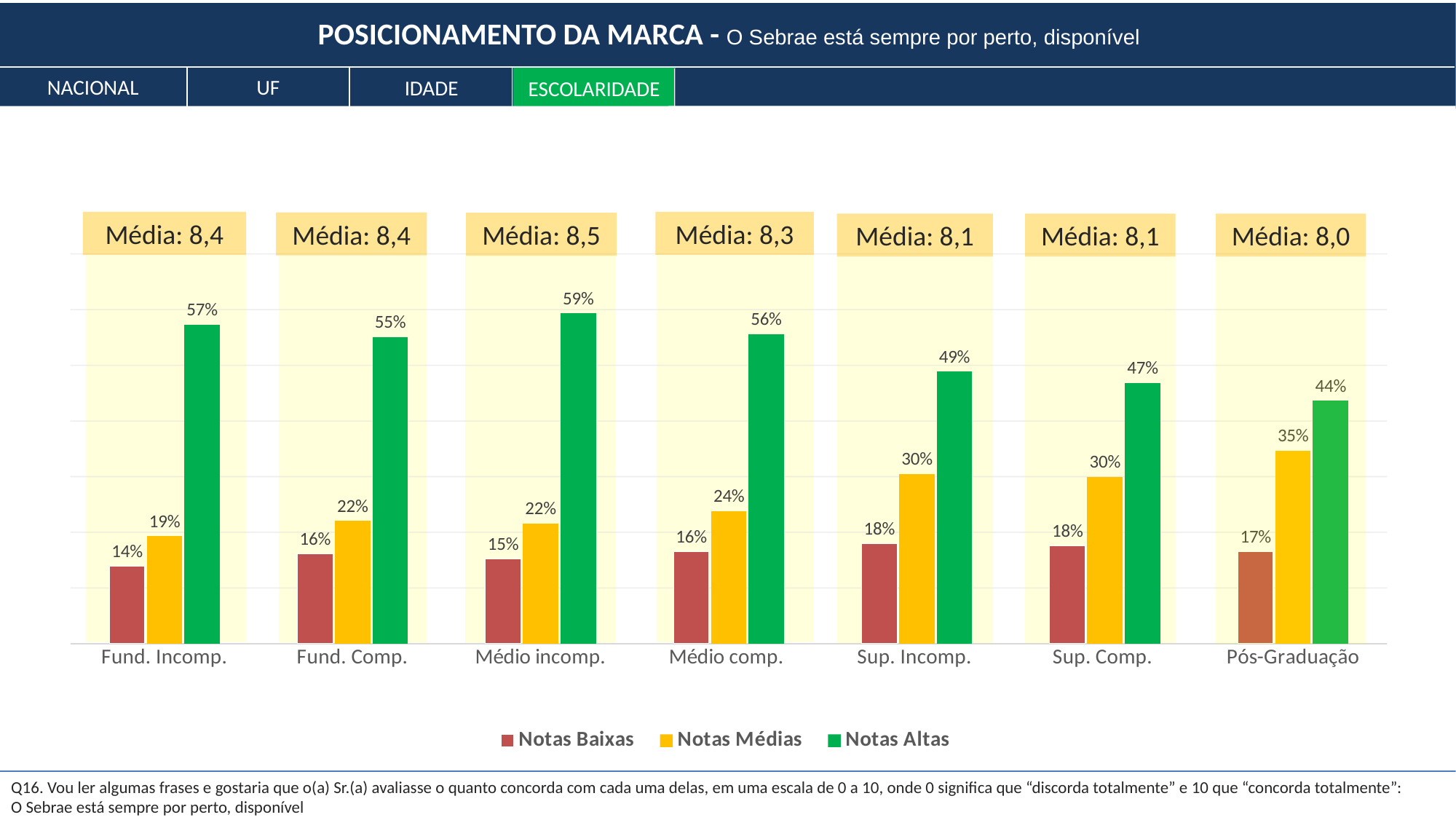
Which category has the lowest Notas Altas value? Pós-Graduação How many series does the legend list? 3 What is the Notas Baixas value for Fund. Incomp.? 14% What is the Notas Altas value for Médio incomp.? 59% What kind of chart is shown on the slide? Bar chart Which tab is highlighted in green at the top of the slide? ESCOLARIDADE How many education categories are shown on the x axis? 7 Which is larger, the Notas Médias value for Médio comp. or for Sup. Incomp.? Sup. Incomp. What is the Média shown above the Pós-Graduação category? 8,0 What is the Notas Médias value for Pós-Graduação? 35% Which category has the highest Notas Altas value? Médio incomp. What is the difference between the Notas Altas and Notas Baixas values for Sup. Comp.? 29%